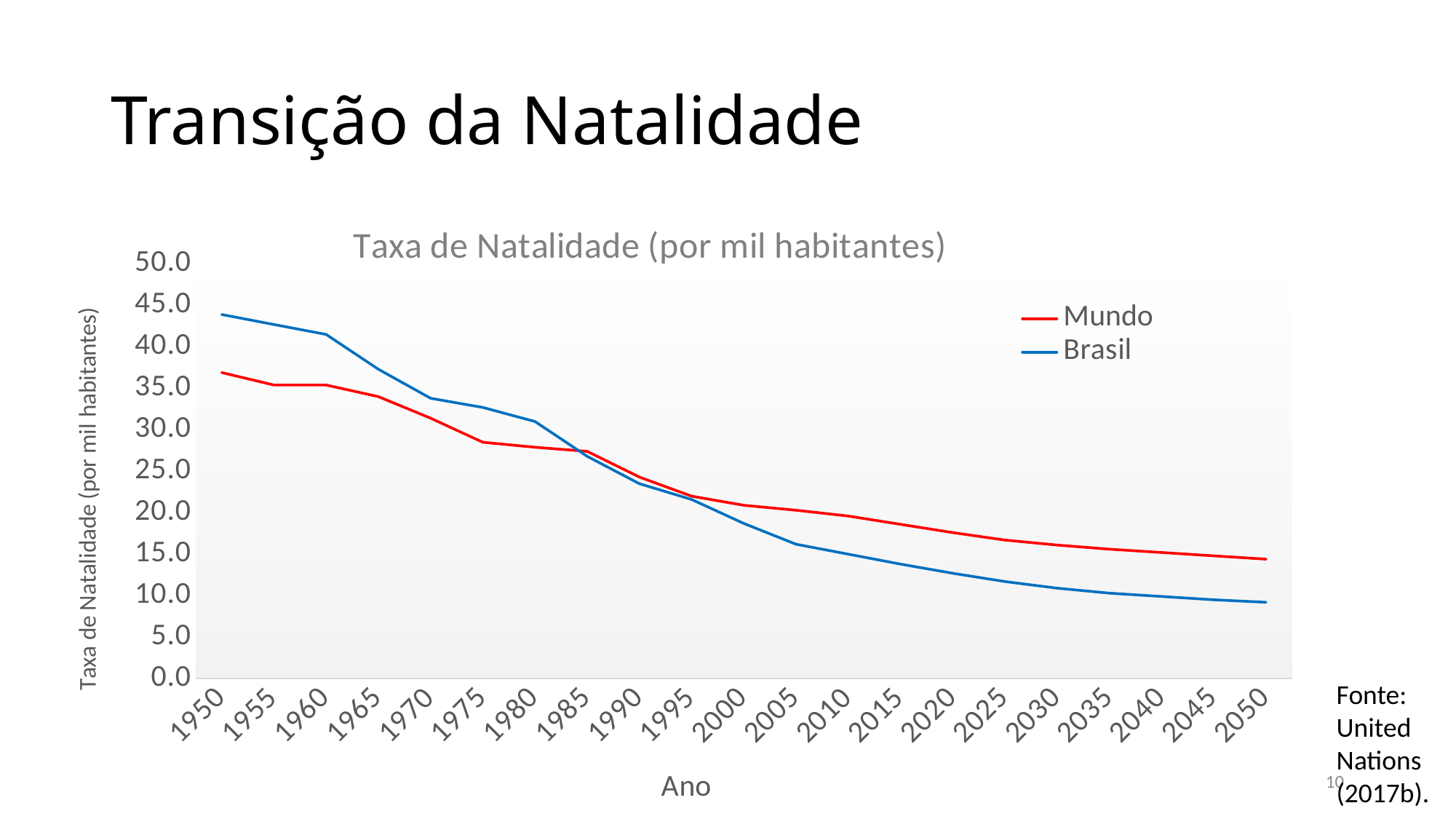
How many years are marked along the x axis? 21 How many series does the legend list? 2 Is the value for Brasil in 1950 greater or less than 40.0? greater Is the value for Mundo in 2050 greater or less than 20.0? less What is the title of the chart? Taxa de Natalidade (por mil habitantes) In 2050, which series has the higher value, Mundo or Brasil? Mundo In 1950, which series has the higher value, Mundo or Brasil? Brasil Does the Brasil line rise or fall from 1950 to 2050? fall Does the Mundo line rise or fall from 1950 to 2050? fall What kind of chart is shown on the slide? line chart Is the value for Brasil in 2050 greater or less than 10.0? less